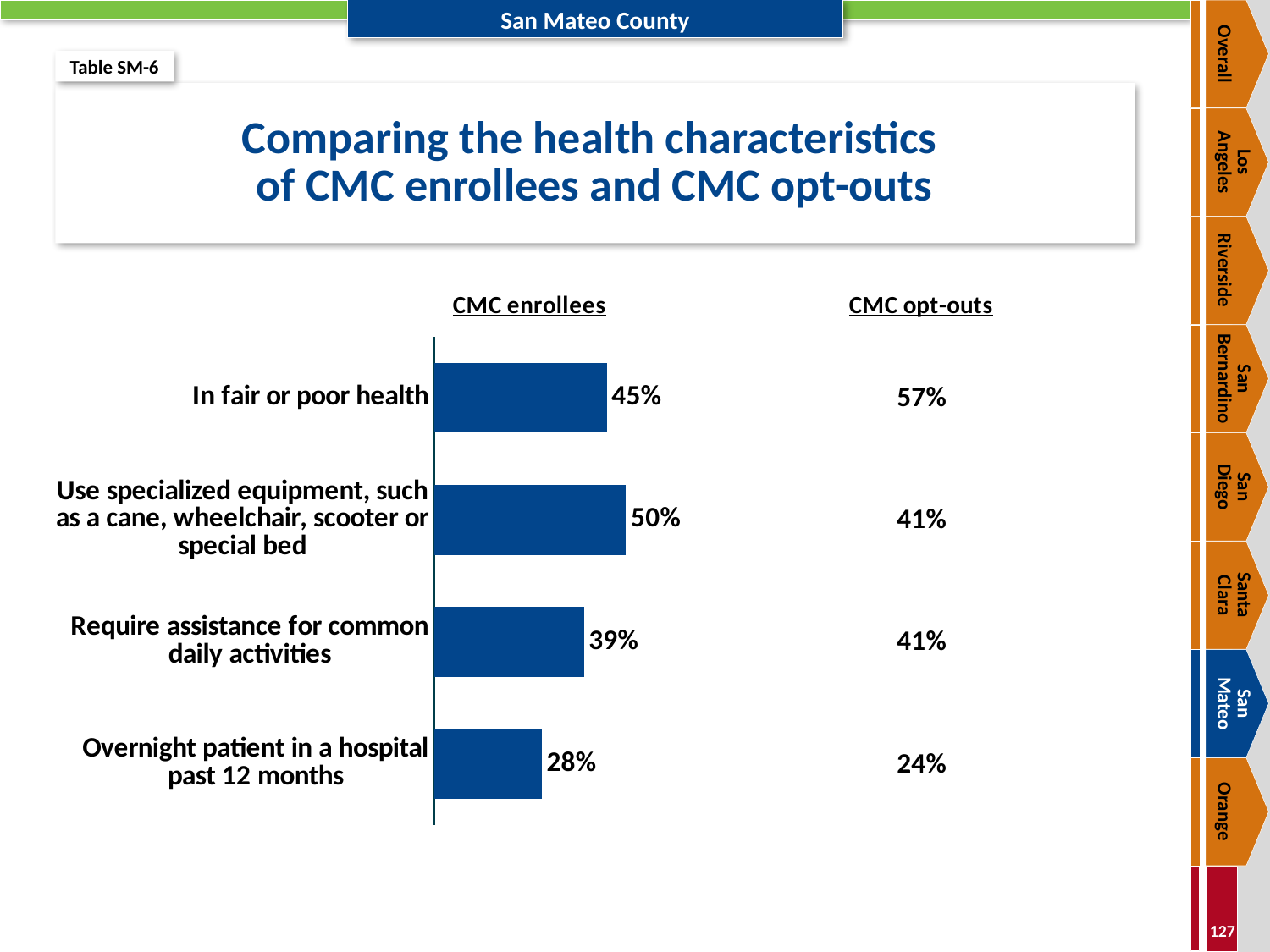
What type of chart is used to show the CMC enrollees values? Bar chart Which health characteristic has the highest percentage among CMC enrollees? Use specialized equipment, such as a cane, wheelchair, scooter or special bed What percentage of CMC enrollees are in fair or poor health? 45% What percentage of CMC opt-outs are in fair or poor health? 57% What percentage of CMC enrollees were an overnight patient in a hospital in the past 12 months? 28% Which group has a higher percentage of overnight hospital patients in the past 12 months, CMC enrollees or CMC opt-outs? CMC enrollees What is the difference between the CMC opt-outs and CMC enrollees percentages for being in fair or poor health? 12% Which group has a higher percentage requiring assistance for common daily activities, CMC enrollees or CMC opt-outs? CMC opt-outs Which health characteristic has the lowest percentage among CMC enrollees? Overnight patient in a hospital past 12 months What is the difference between the CMC enrollees and CMC opt-outs percentages for using specialized equipment? 9% What percentage of CMC opt-outs use specialized equipment, such as a cane, wheelchair, scooter or special bed? 41% How many health characteristics are shown in the chart? 4